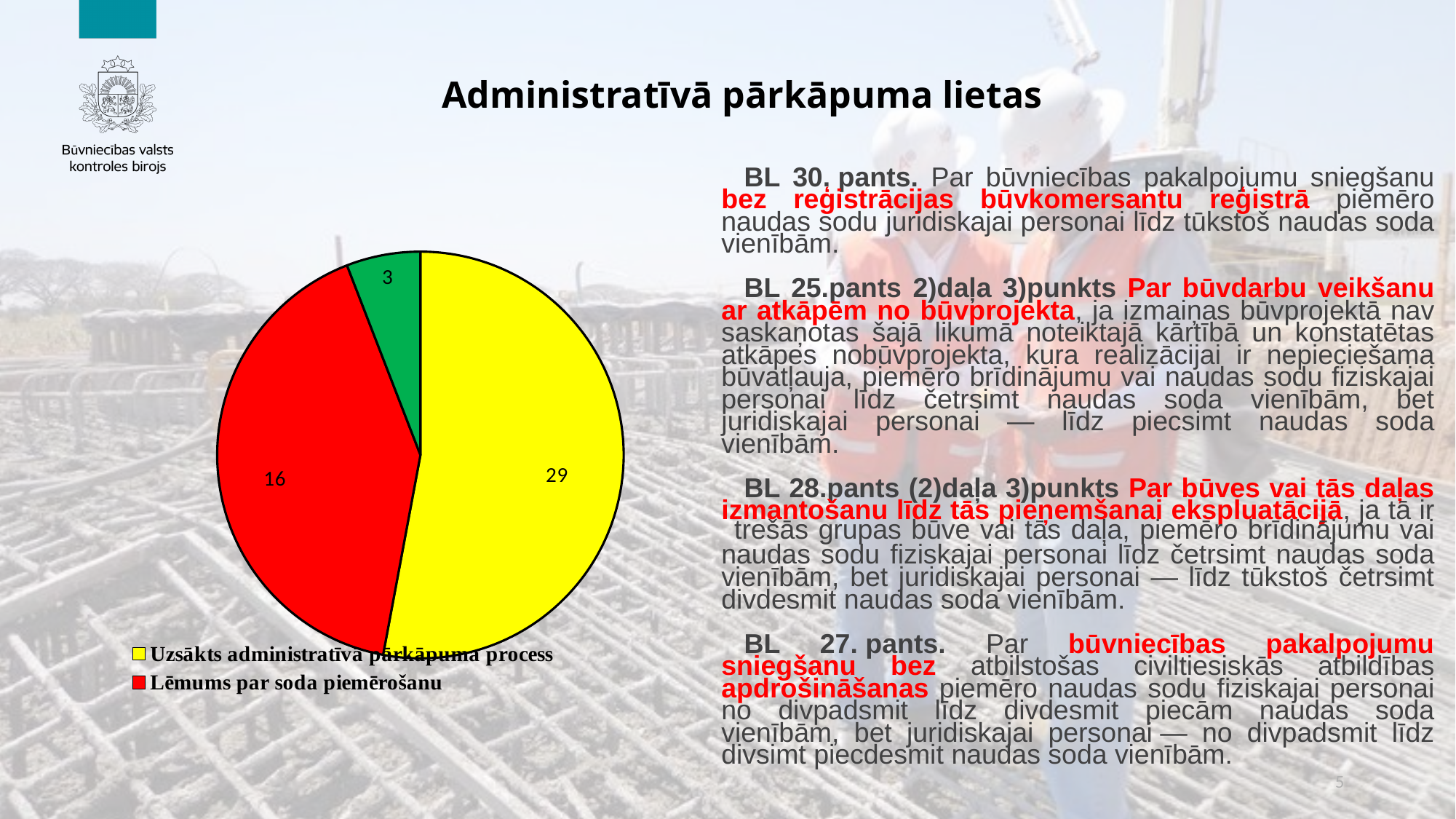
What is the total of all values shown in the pie chart? 48 What colour represents "Lēmums par soda piemērošanu" in the pie chart? red What is the smallest value shown in the pie chart? 3 What value is shown for "Lēmums par soda piemērošanu"? 16 Which category has the largest slice in the pie chart? Uzsākts administratīvā pārkāpuma process What share of the pie does the green slice (3) represent? 6.25% What is the difference between the values for "Uzsākts administratīvā pārkāpuma process" and "Lēmums par soda piemērošanu"? 13 What value is shown for "Uzsākts administratīvā pārkāpuma process"? 29 What kind of chart is shown on the slide? pie chart Which is larger: "Uzsākts administratīvā pārkāpuma process" or "Lēmums par soda piemērošanu"? Uzsākts administratīvā pārkāpuma process What value is shown on the green slice of the pie chart? 3 How many slices does the pie chart have? 3